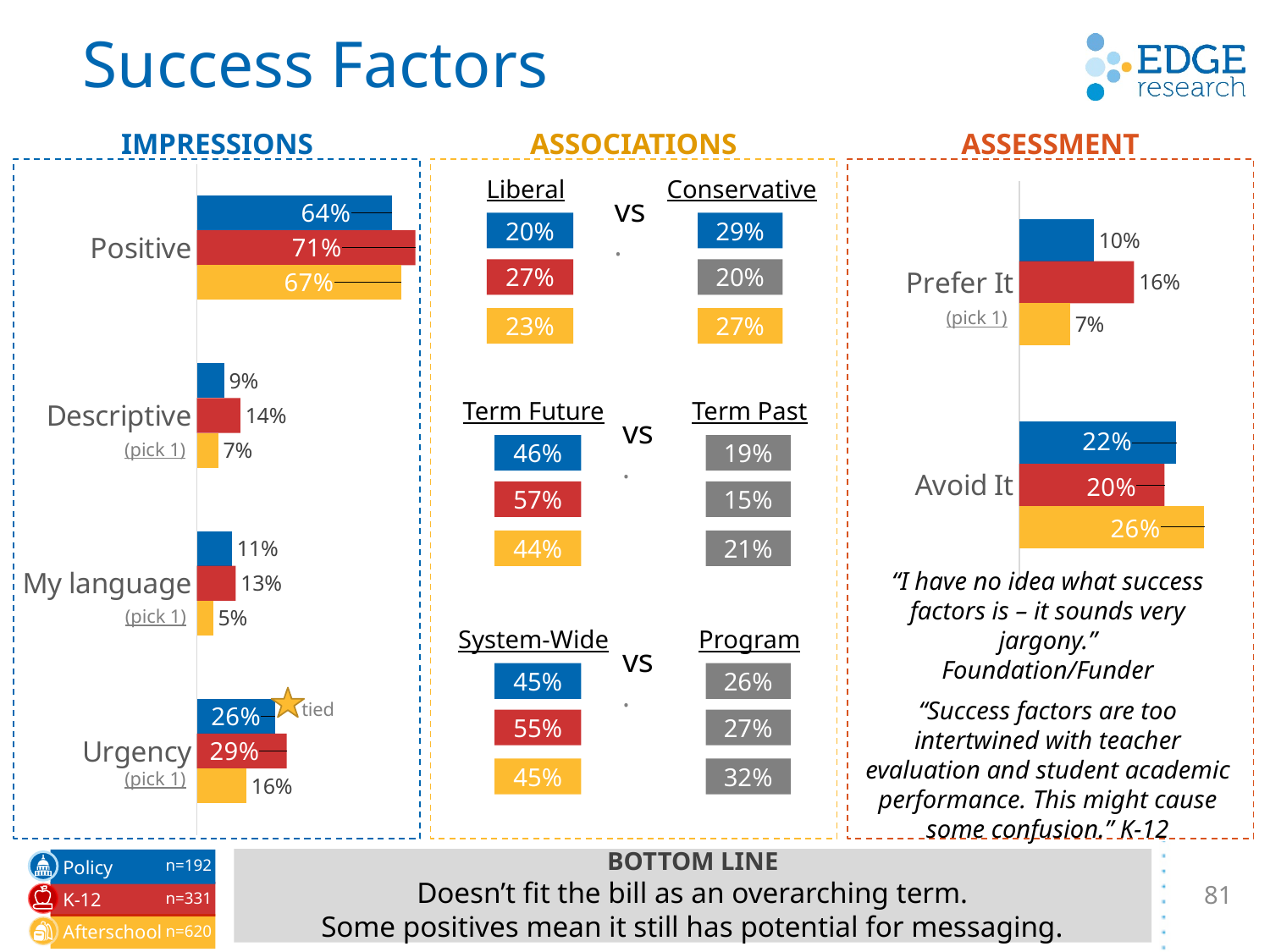
How many categories does the IMPRESSIONS chart show? 4 In the ASSESSMENT chart, what is the value for K-12 on Prefer It? 16% In the ASSESSMENT chart, what is the difference between the Policy and K-12 values for Avoid It? 2% What type of chart is the IMPRESSIONS chart? Bar chart In the IMPRESSIONS chart, what is the value for K-12 on Positive? 71% In the ASSESSMENT chart, what is the value for Afterschool on Avoid It? 26% In the IMPRESSIONS chart, what is the value for Policy on Descriptive? 9% In the ASSESSMENT chart, which group has the lowest value for Prefer It? Afterschool In the IMPRESSIONS chart, what is the difference between the K-12 and Afterschool values for My language? 8% In the IMPRESSIONS chart, what is the value for Afterschool on Urgency? 16% In the IMPRESSIONS chart, which is larger for Descriptive: the Policy value or the K-12 value? K-12 In the IMPRESSIONS chart, which category has the highest values across all three groups? Positive